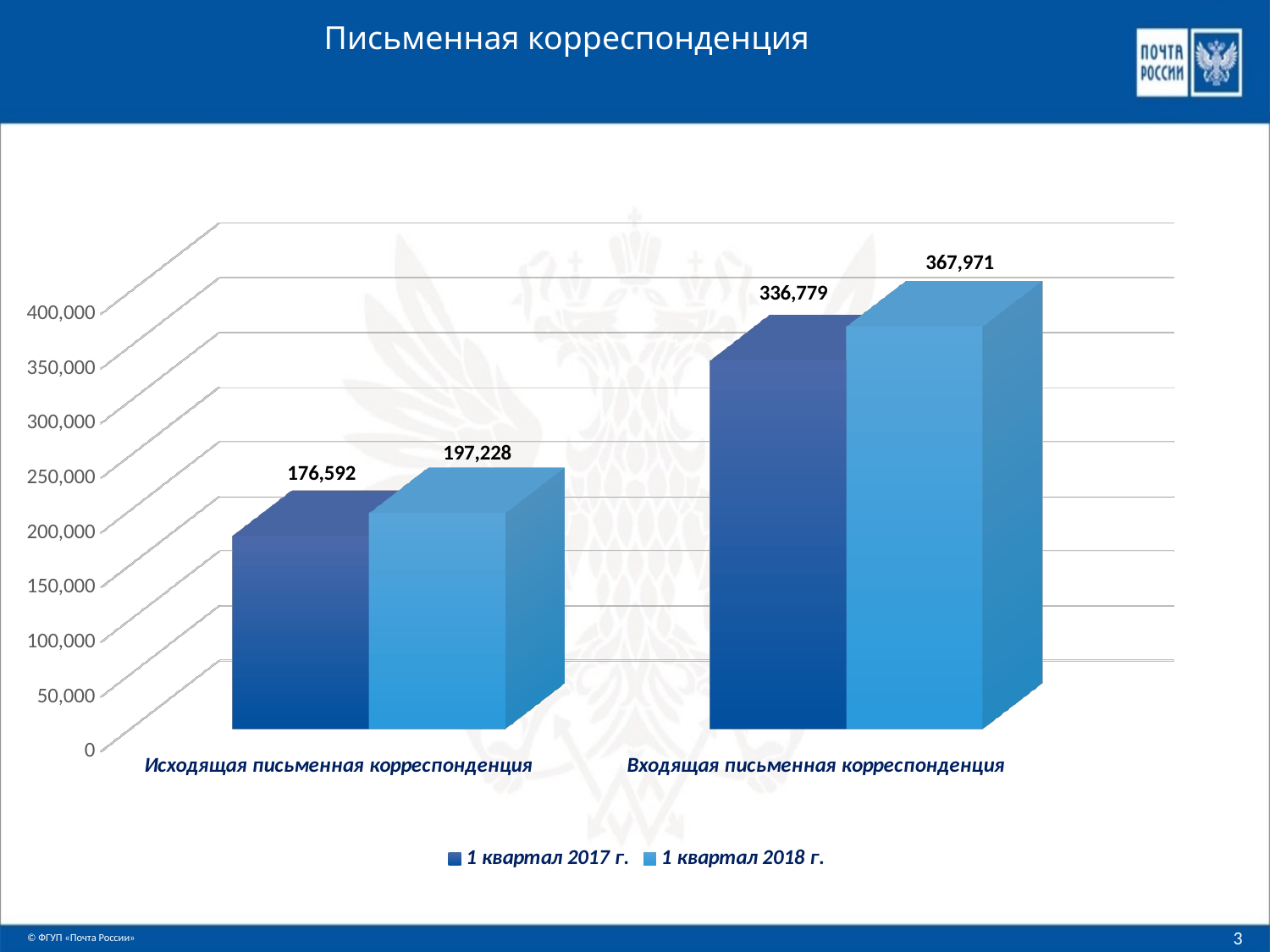
What is the value for Исходящая письменная корреспонденция in 1 квартал 2018 г.? 197,228 How many series does the legend list? 2 What is the value for Входящая письменная корреспонденция in 1 квартал 2018 г.? 367,971 What is the difference between the 1 квартал 2018 г. and 1 квартал 2017 г. values for Исходящая письменная корреспонденция? 20,636 What is the value for Входящая письменная корреспонденция in 1 квартал 2017 г.? 336,779 How many categories are shown on the x axis? 2 What is the value for Исходящая письменная корреспонденция in 1 квартал 2017 г.? 176,592 Which category has the lowest value in 1 квартал 2017 г.? Исходящая письменная корреспонденция What kind of chart is shown on the slide? Bar chart Which is larger for Исходящая письменная корреспонденция: the 1 квартал 2017 г. value or the 1 квартал 2018 г. value? 1 квартал 2018 г. What is the difference between the 1 квартал 2018 г. and 1 квартал 2017 г. values for Входящая письменная корреспонденция? 31,192 Which category has the highest value in 1 квартал 2018 г.? Входящая письменная корреспонденция